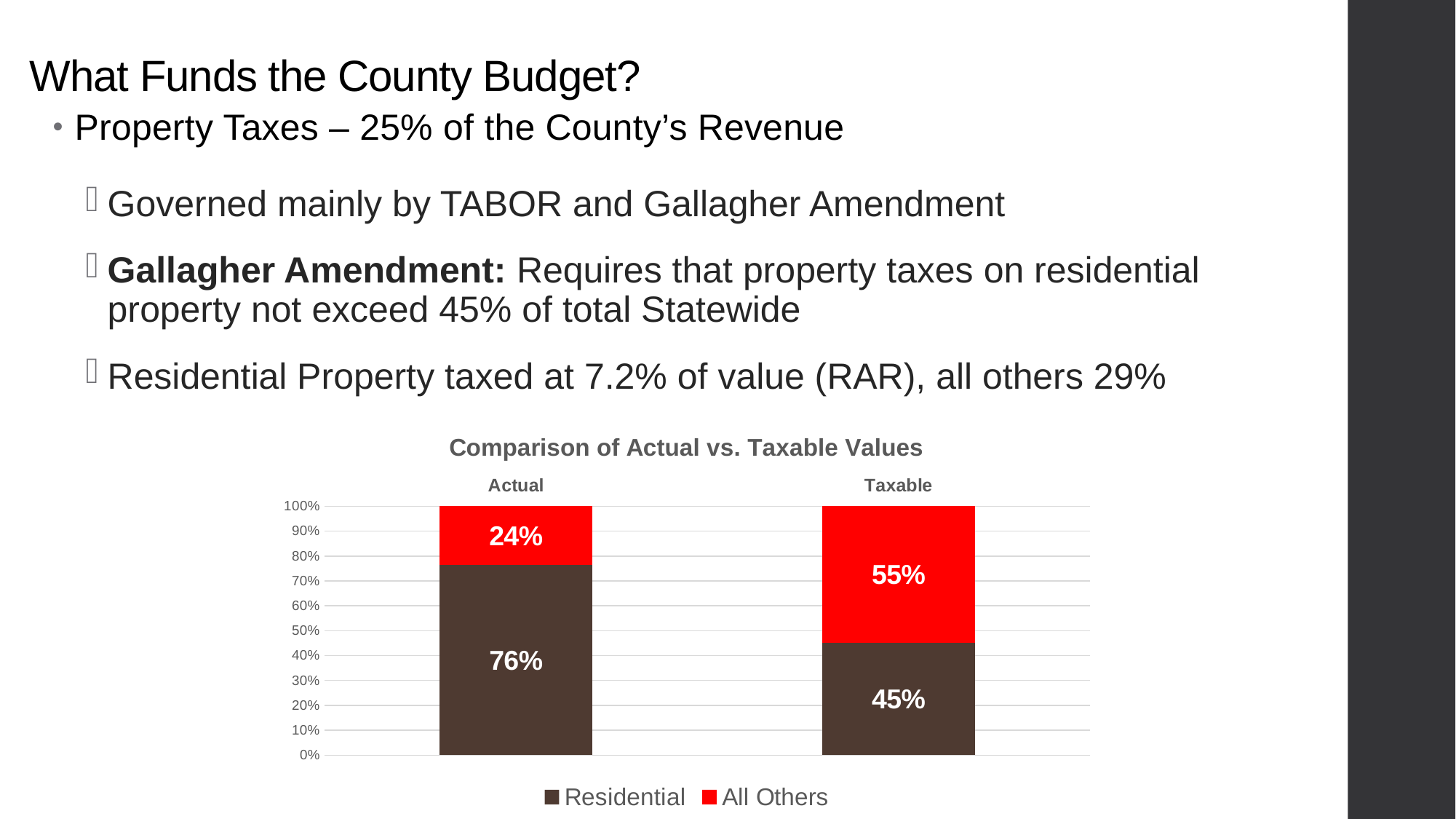
How many categories are shown on the x axis? 2 How many series does the legend list? 2 What is the Residential value for the Actual bar? 76% What is the All Others value for the Taxable bar? 55% What is the Residential value for the Taxable bar? 45% What is the difference between the Residential values for Actual and Taxable? 31% What is the title of the chart? Comparison of Actual vs. Taxable Values What kind of chart is shown on the slide? Stacked bar chart Which category has the higher All Others share, Actual or Taxable? Taxable What is the difference between the All Others values for Taxable and Actual? 31% Which category has the higher Residential share, Actual or Taxable? Actual What is the All Others value for the Actual bar? 24%